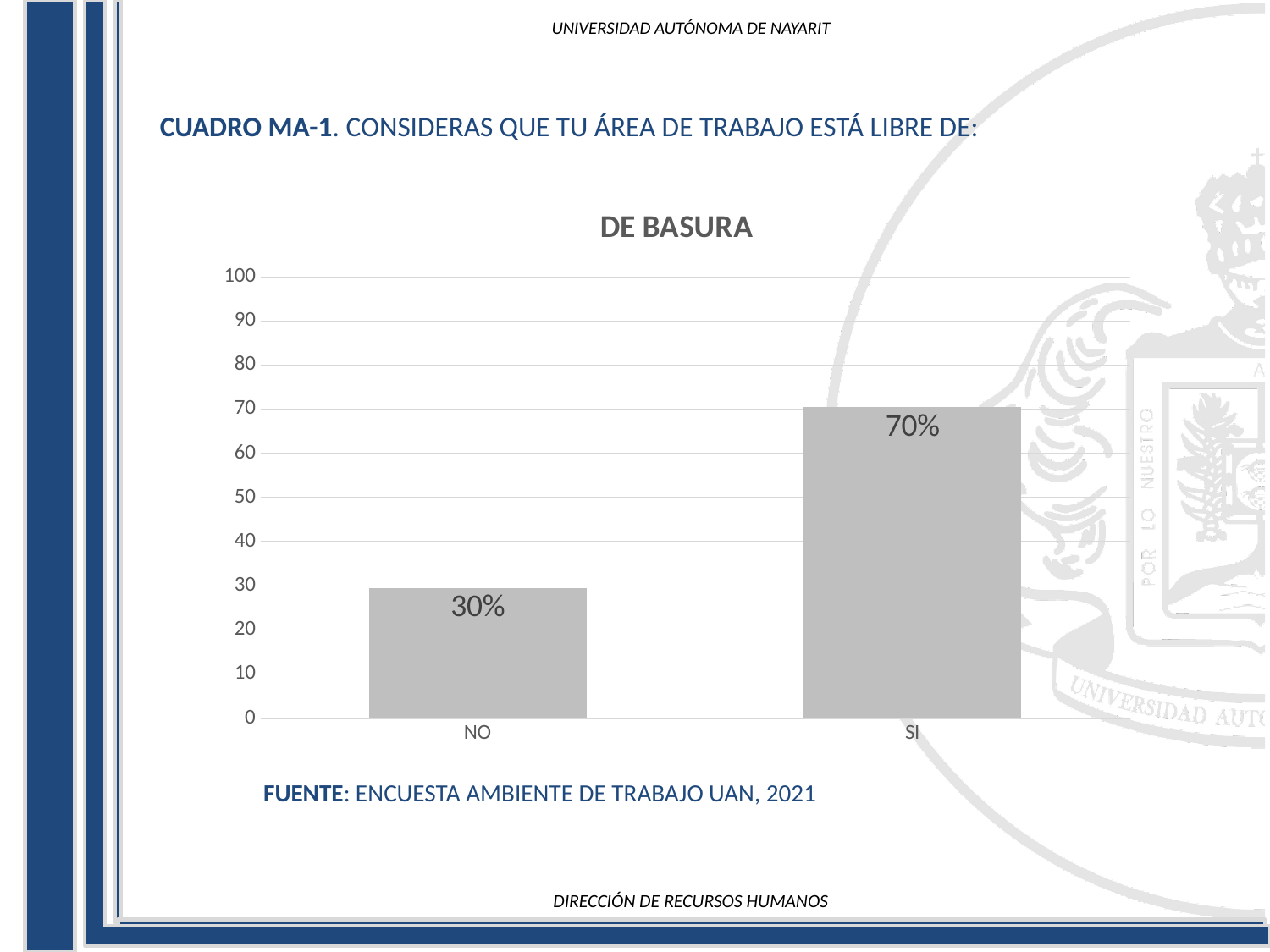
What kind of chart is shown? bar chart Which is larger, the value for NO or the value for SI? SI Is the value for NO greater or less than 40? less Which category has the highest value? SI How many categories are shown on the x axis? 2 Which category has the lowest value? NO What is the title of the chart? DE BASURA What is the value for NO? 30% What is the value for SI? 70% What is the difference between the values for SI and NO? 40% What is the maximum value shown on the y axis? 100 Is the value for SI greater or less than 50? greater